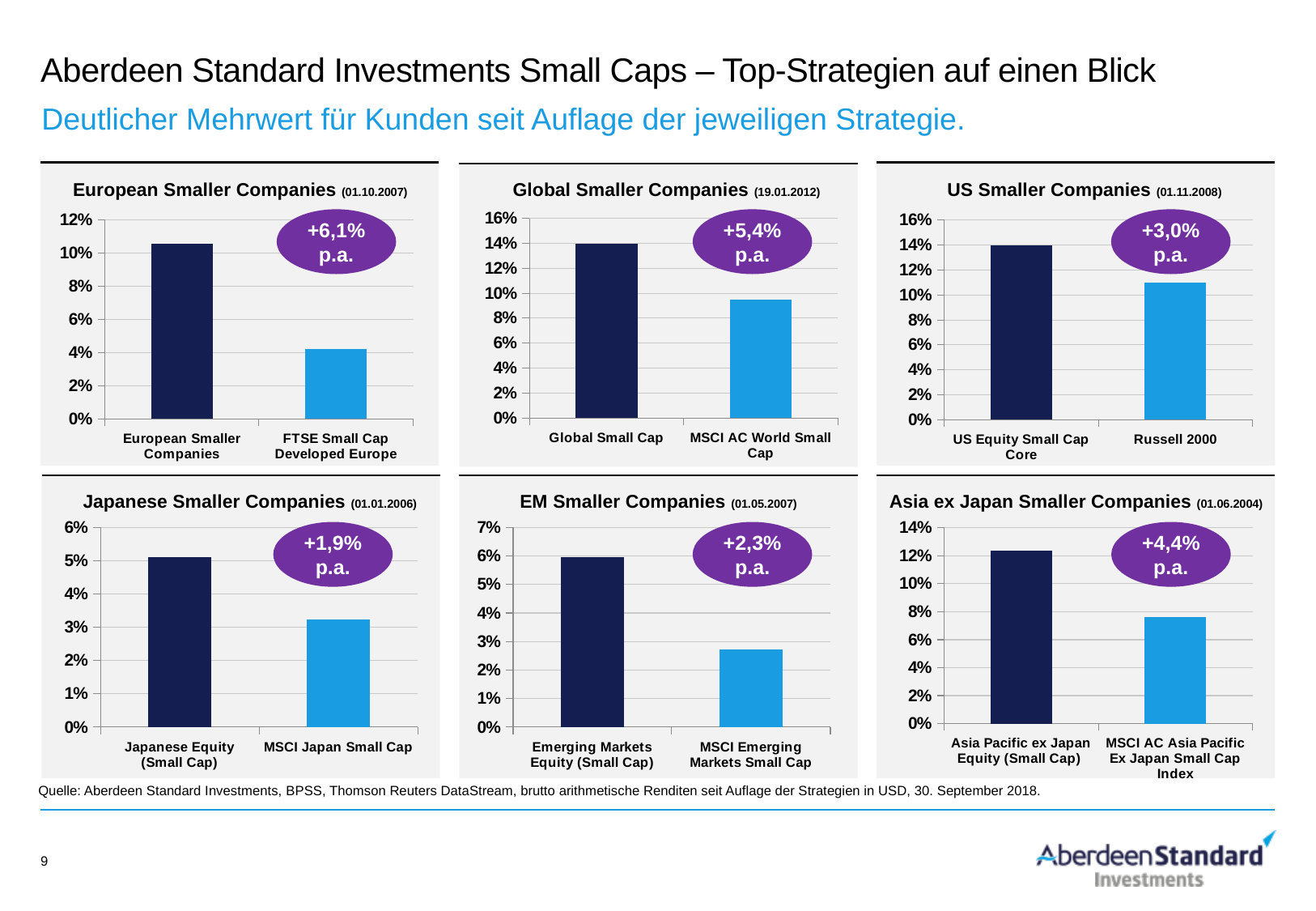
In the EM Smaller Companies chart, is the value for MSCI Emerging Markets Small Cap greater or less than 4%? less In the Japanese Smaller Companies chart, which category has the lowest value? MSCI Japan Small Cap What date is shown next to the title of the Asia ex Japan Smaller Companies chart? 01.06.2004 What type of chart is the US Smaller Companies chart? bar chart In the Japanese Smaller Companies chart, is the value for Japanese Equity (Small Cap) greater or less than 4%? greater In the European Smaller Companies chart, which of the two bars is higher: European Smaller Companies or FTSE Small Cap Developed Europe? European Smaller Companies In the US Smaller Companies chart, is the value for Russell 2000 greater or less than 8%? greater How many categories are plotted in the Global Smaller Companies chart? 2 What annual outperformance is shown in the oval on the US Smaller Companies chart? +3,0% p.a.